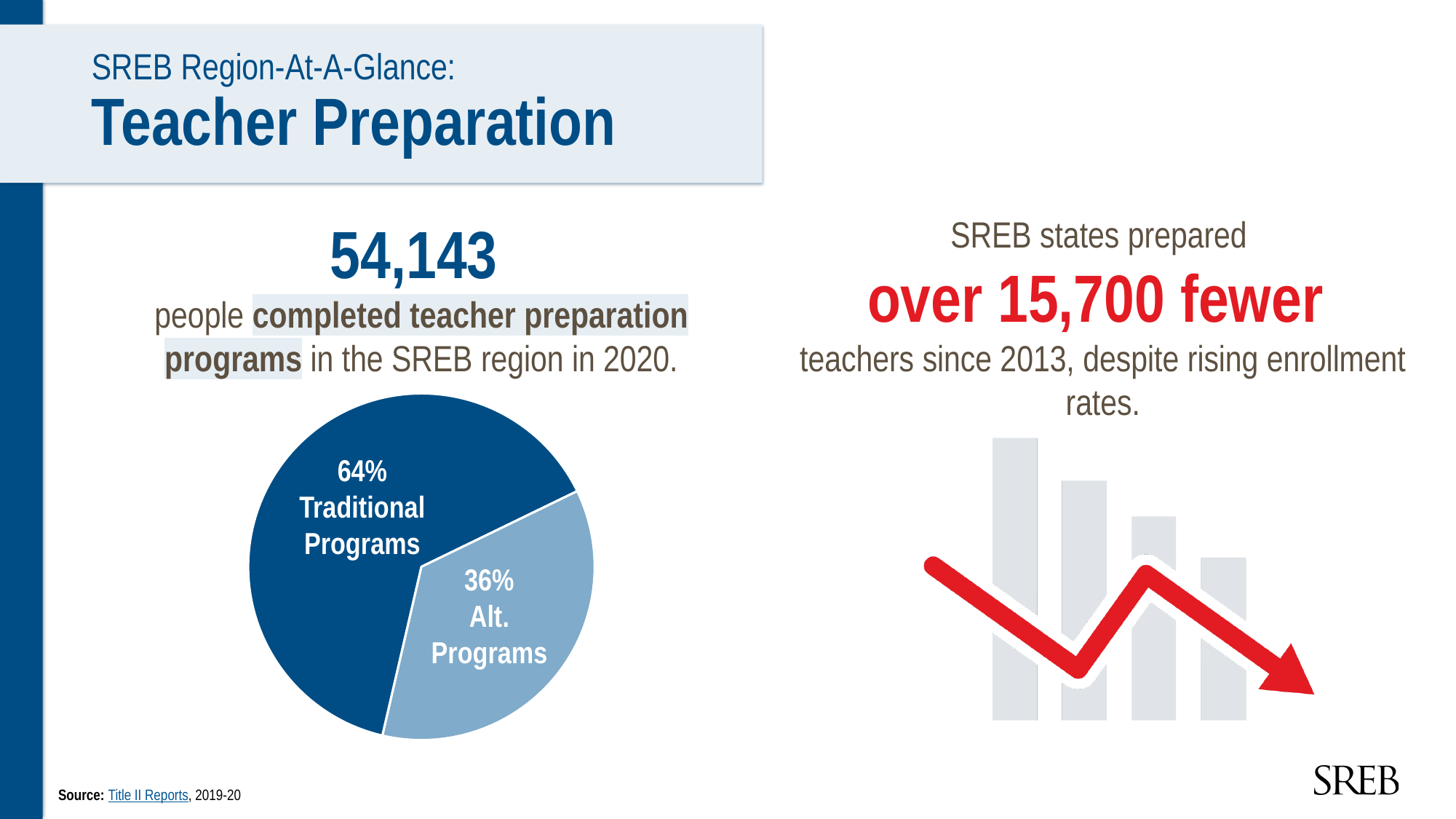
Is the Traditional Programs share in the pie chart greater or less than 50%? greater What colour is the Traditional Programs slice in the pie chart? dark blue Which is larger in the pie chart: Traditional Programs or Alt. Programs? Traditional Programs Which slice of the pie chart is the smallest? Alt. Programs In the pie chart, what share of completers came from Traditional Programs? 64% What colour is the Alt. Programs slice in the pie chart? light blue How many slices does the pie chart have? 2 Which slice of the pie chart is the largest? Traditional Programs In the pie chart, what share of completers came from Alt. Programs? 36% What is the total of the two slices shown in the pie chart? 100% What is the difference in percentage points between the Traditional Programs slice and the Alt. Programs slice? 28 What type of chart is shown on the left side of the slide? pie chart